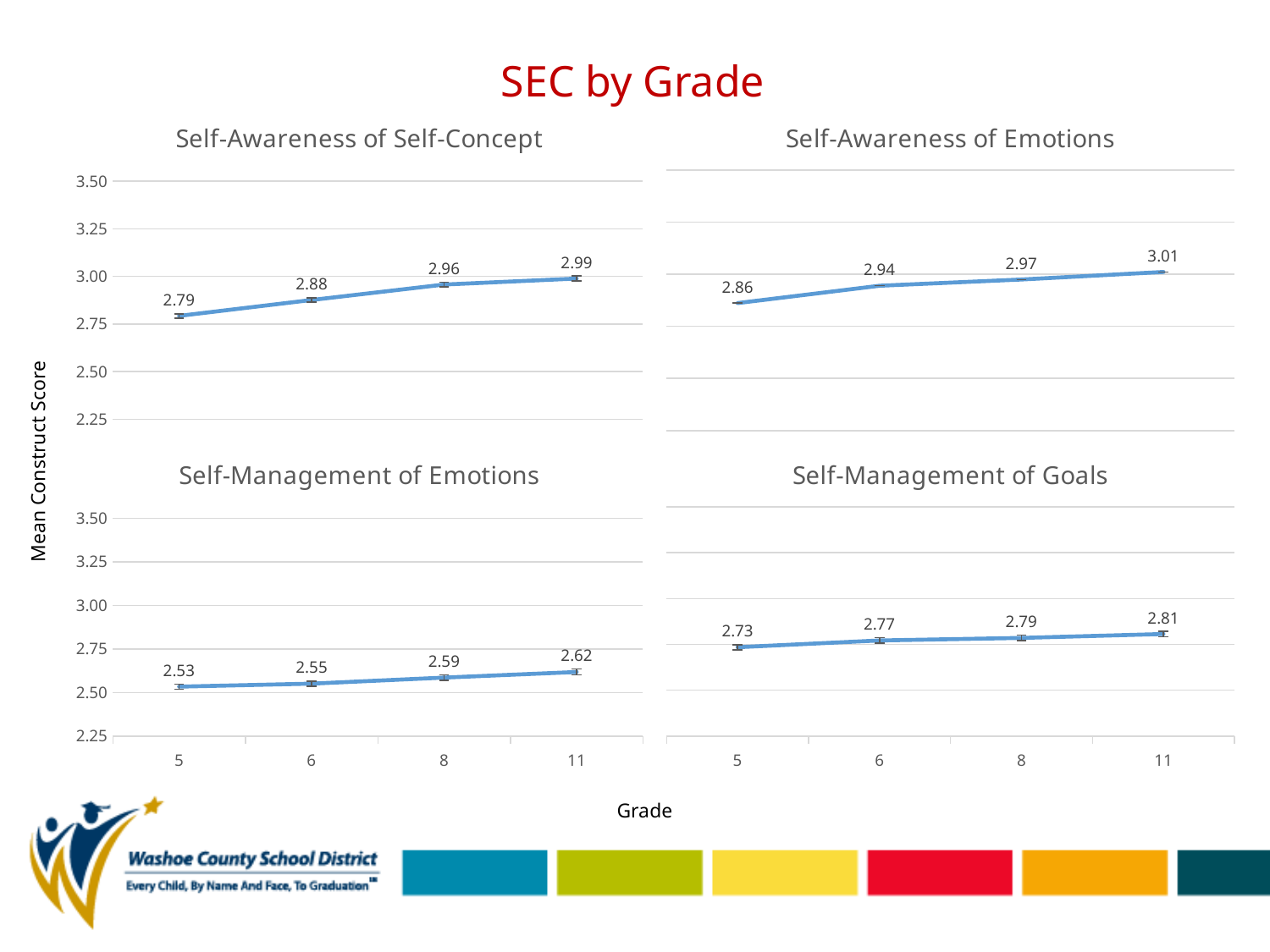
In the Self-Management of Goals chart, what is the difference between the values for grade 11 and grade 5? 0.08 In the Self-Awareness of Emotions chart, what is the difference between the values for grade 11 and grade 5? 0.15 How many grade points are plotted in the Self-Management of Goals chart? 4 What kind of chart is the Self-Awareness of Self-Concept chart? line chart Which is larger: the grade 8 value in the Self-Awareness of Emotions chart or the grade 8 value in the Self-Management of Goals chart? Self-Awareness of Emotions In the Self-Awareness of Self-Concept chart, what is the value for grade 5? 2.79 In the Self-Management of Emotions chart, what is the value for grade 8? 2.59 In the Self-Management of Emotions chart, which grade has the lowest value? 5 In the Self-Management of Goals chart, what is the value for grade 6? 2.77 In the Self-Awareness of Emotions chart, what is the value for grade 11? 3.01 In the Self-Awareness of Self-Concept chart, which grade has the highest value? 11 In the Self-Management of Emotions chart, is the value for grade 11 greater or less than 2.75? less